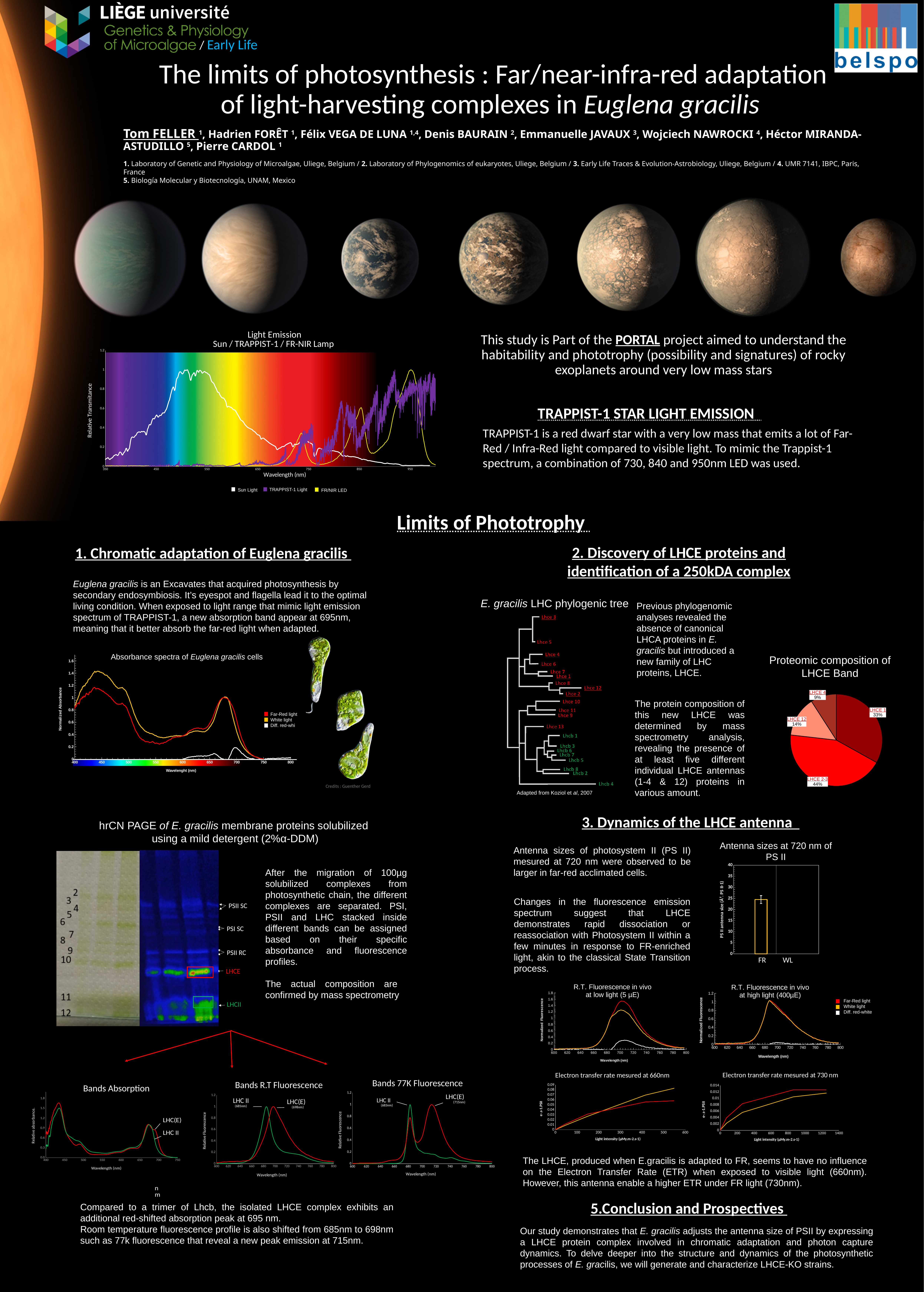
In the 'Proteomic composition of LHCE Band' pie chart, which protein has the smallest share? LHCE 4 In the 'Proteomic composition of LHCE Band' pie chart, how many slices are there? 4 In the 'Antenna sizes at 720 nm of PS II' chart, is the value for FR greater or less than 20? greater How many series does the legend of the 'Absorbance spectra of Euglena gracilis cells' chart list? 3 In the 'Proteomic composition of LHCE Band' pie chart, what percentage is shown for LHCE 2-3? 44% How many series does the legend of the 'Light Emission Sun / TRAPPIST-1 / FR-NIR Lamp' chart list? 3 What kind of chart is 'Proteomic composition of LHCE Band'? pie chart In the 'Bands 77K Fluorescence' chart, at what wavelength is the LHC(E) peak labelled? 715nm What kind of chart is 'Antenna sizes at 720 nm of PS II'? bar chart In the 'Proteomic composition of LHCE Band' pie chart, what percentage is shown for LHCE 1? 33% In the 'Proteomic composition of LHCE Band' pie chart, what is the difference in percentage points between LHCE 1 and LHCE 12? 19 In the 'Proteomic composition of LHCE Band' pie chart, which protein has the largest share? LHCE 2-3